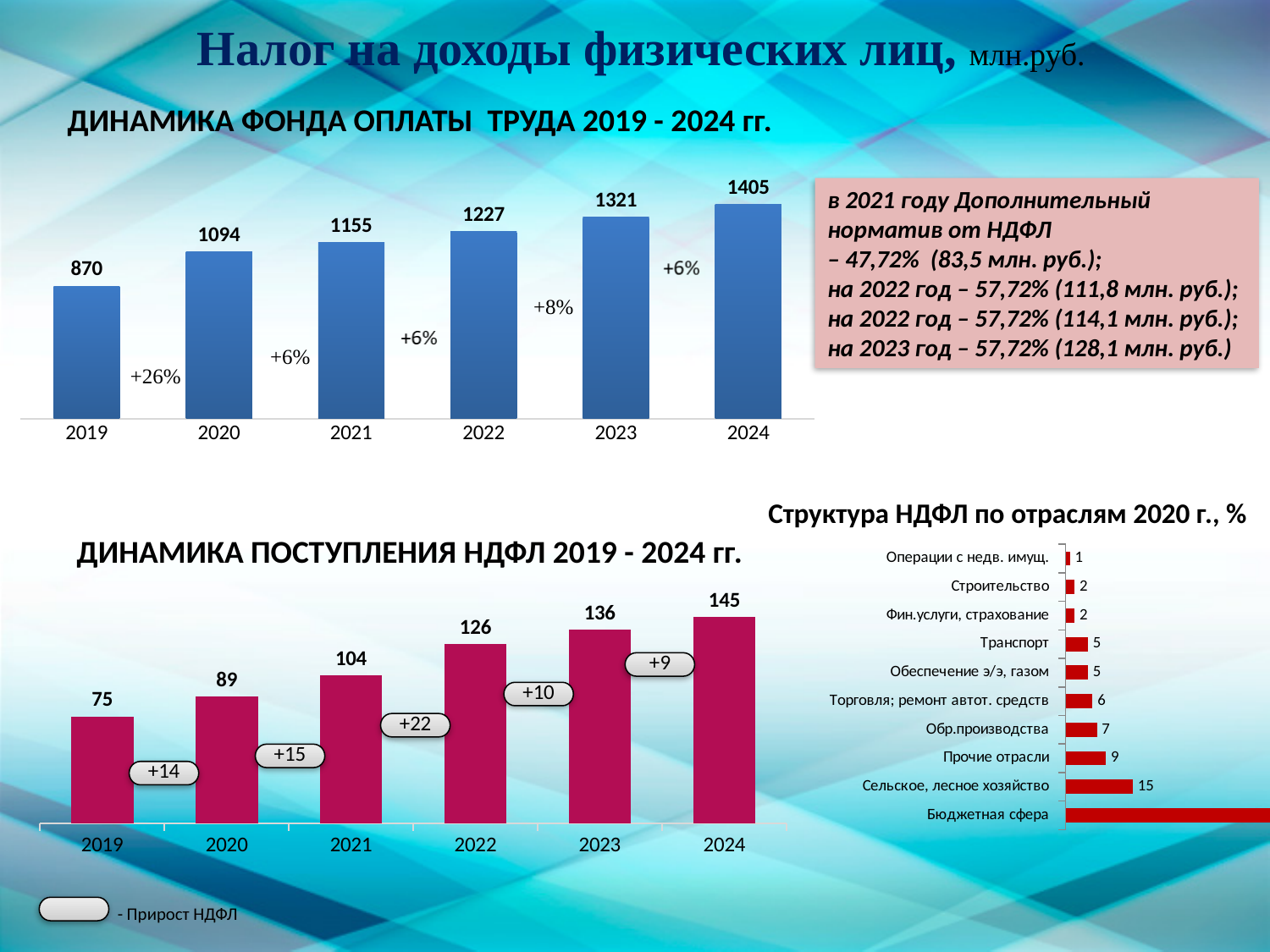
In the chart 'Структура НДФЛ по отраслям 2020 г., %', what is the value for 'Сельское, лесное хозяйство'? 15 In the chart 'ДИНАМИКА ПОСТУПЛЕНИЯ НДФЛ 2019 - 2024 гг.', what is the value for 2022? 126 In the chart 'ДИНАМИКА ПОСТУПЛЕНИЯ НДФЛ 2019 - 2024 гг.', how many years are plotted? 6 In the chart 'ДИНАМИКА ПОСТУПЛЕНИЯ НДФЛ 2019 - 2024 гг.', what is the difference between the values for 2021 and 2019? 29 In the chart 'ДИНАМИКА ФОНДА ОПЛАТЫ ТРУДА 2019 - 2024 гг.', what is the difference between the values for 2024 and 2023? 84 In the chart 'ДИНАМИКА ФОНДА ОПЛАТЫ ТРУДА 2019 - 2024 гг.', what is the value for 2021? 1155 In the chart 'Структура НДФЛ по отраслям 2020 г., %', which is larger: 'Транспорт' or 'Обр.производства'? Обр.производства In the chart 'ДИНАМИКА ПОСТУПЛЕНИЯ НДФЛ 2019 - 2024 гг.', which year has the highest value? 2024 What type of chart is 'Структура НДФЛ по отраслям 2020 г., %'? bar chart In the chart 'ДИНАМИКА ФОНДА ОПЛАТЫ ТРУДА 2019 - 2024 гг.', do the values rise or fall from 2019 to 2024? rise In the chart 'ДИНАМИКА ФОНДА ОПЛАТЫ ТРУДА 2019 - 2024 гг.', what percentage growth is shown between 2019 and 2020? +26% In the chart 'ДИНАМИКА ФОНДА ОПЛАТЫ ТРУДА 2019 - 2024 гг.', which year has the lowest value? 2019